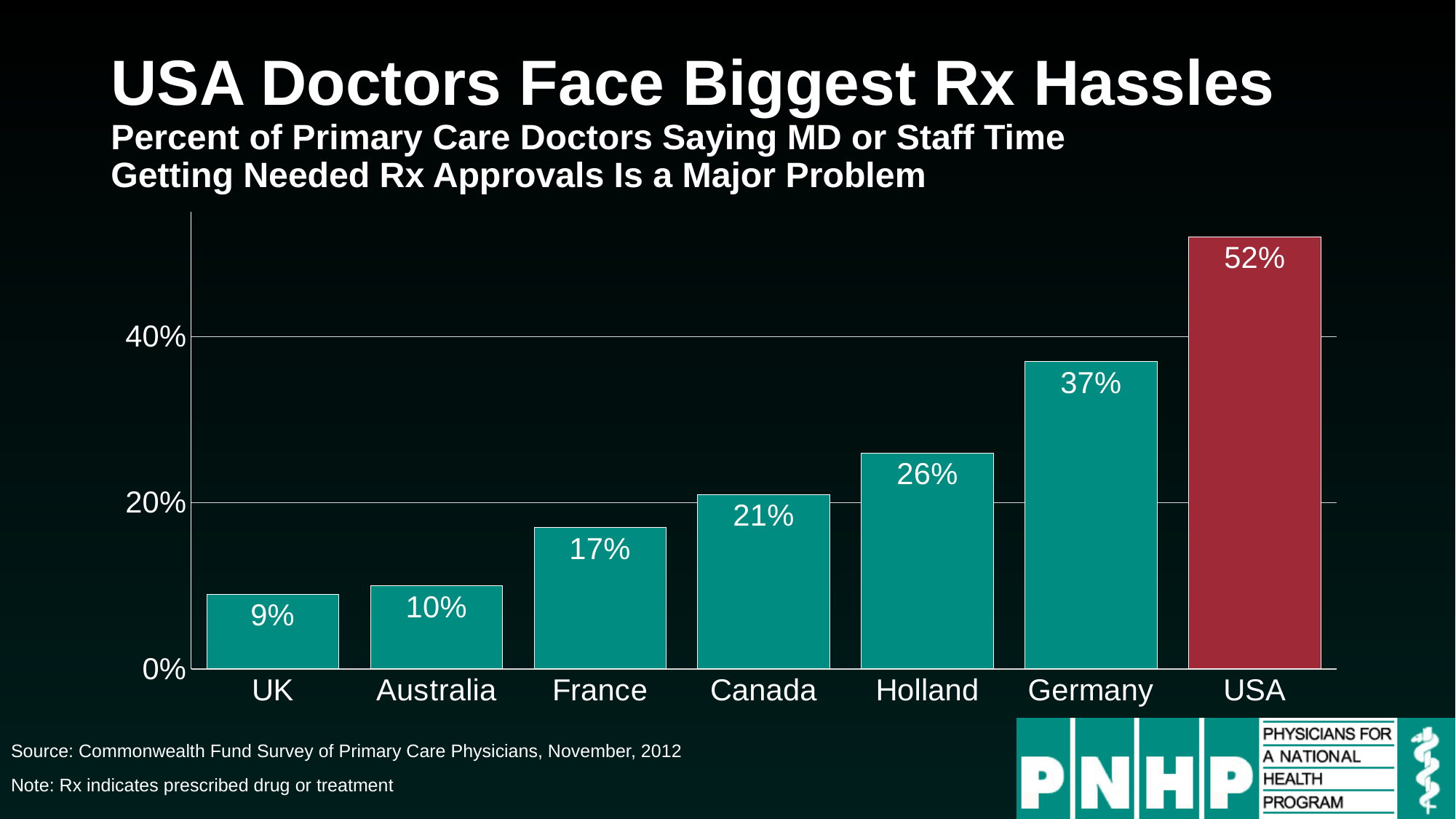
What percent of primary care doctors in Canada say getting needed Rx approvals is a major problem? 21% How many countries are shown on the chart? 7 Which country has the lowest value on the chart? UK Which country has the highest value on the chart? USA What kind of chart is shown on the slide? Bar chart What is the difference between the USA value and the Germany value? 15% What is the value shown for the UK? 9% Is the value for Holland greater or less than 20%? greater Which bar is coloured differently (red) from the others? USA Which is larger, the value for Australia or the value for France? France What is the value shown for Germany? 37% What is the difference between the Holland value and the France value? 9%